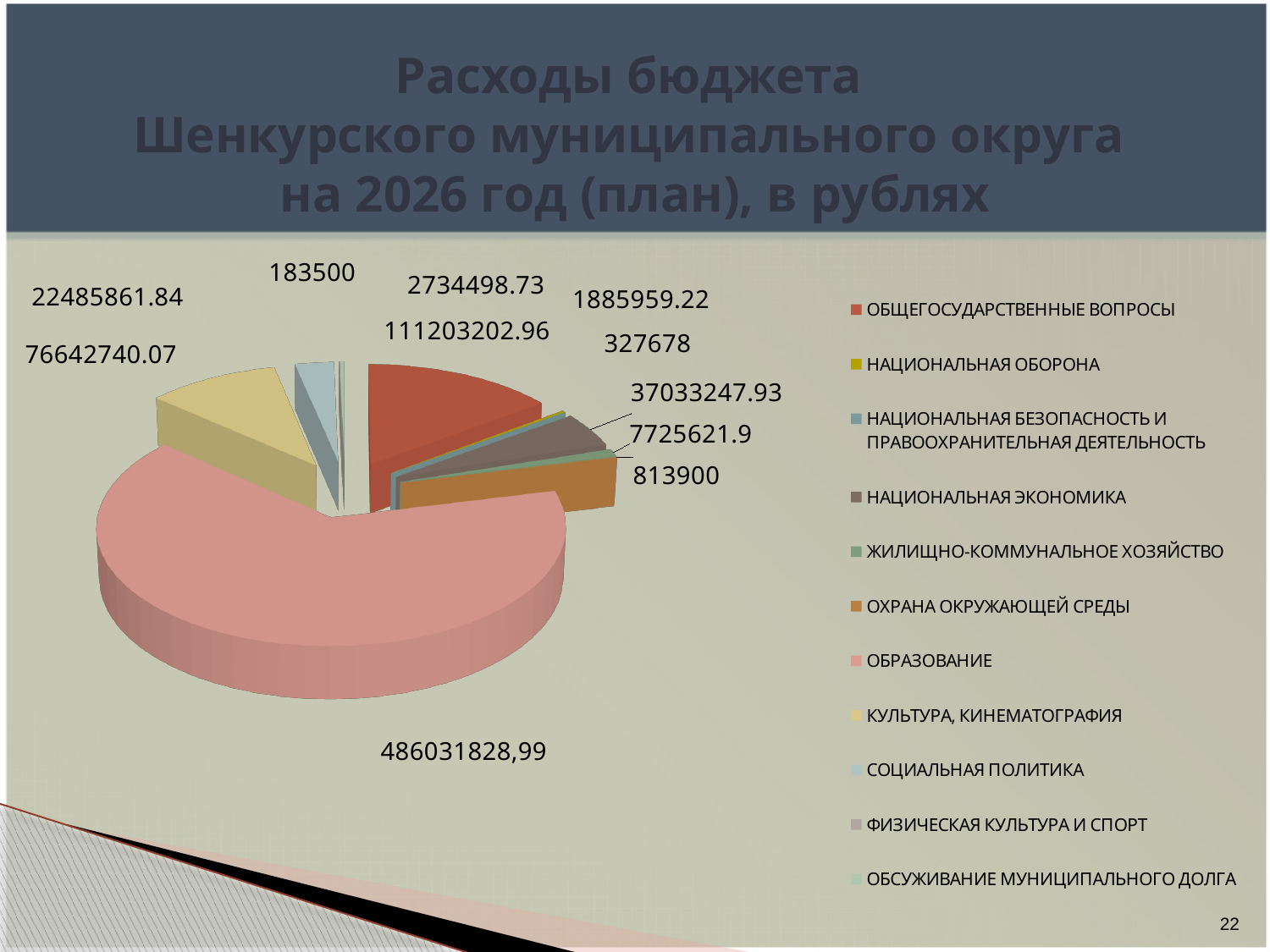
Which category has the largest slice of the pie? ОБРАЗОВАНИЕ What is the value for КУЛЬТУРА, КИНЕМАТОГРАФИЯ? 76642740.07 Which is larger, the value for ОБЩЕГОСУДАРСТВЕННЫЕ ВОПРОСЫ or the value for НАЦИОНАЛЬНАЯ ЭКОНОМИКА? ОБЩЕГОСУДАРСТВЕННЫЕ ВОПРОСЫ How many categories does the legend list? 11 What is the value for ОБЩЕГОСУДАРСТВЕННЫЕ ВОПРОСЫ? 111203202.96 What is the value for ОБРАЗОВАНИЕ? 486031828,99 What type of chart is shown on the slide? Pie chart What is the title of the chart slide? Расходы бюджета Шенкурского муниципального округа на 2026 год (план), в рублях What is the value for НАЦИОНАЛЬНАЯ ЭКОНОМИКА? 37033247.93 What is the value for СОЦИАЛЬНАЯ ПОЛИТИКА? 22485861.84 What is the difference between the value for ОБЩЕГОСУДАРСТВЕННЫЕ ВОПРОСЫ and the value for НАЦИОНАЛЬНАЯ ЭКОНОМИКА? 74169955.03 Which is larger, the value for ОБРАЗОВАНИЕ or the value for КУЛЬТУРА, КИНЕМАТОГРАФИЯ? ОБРАЗОВАНИЕ